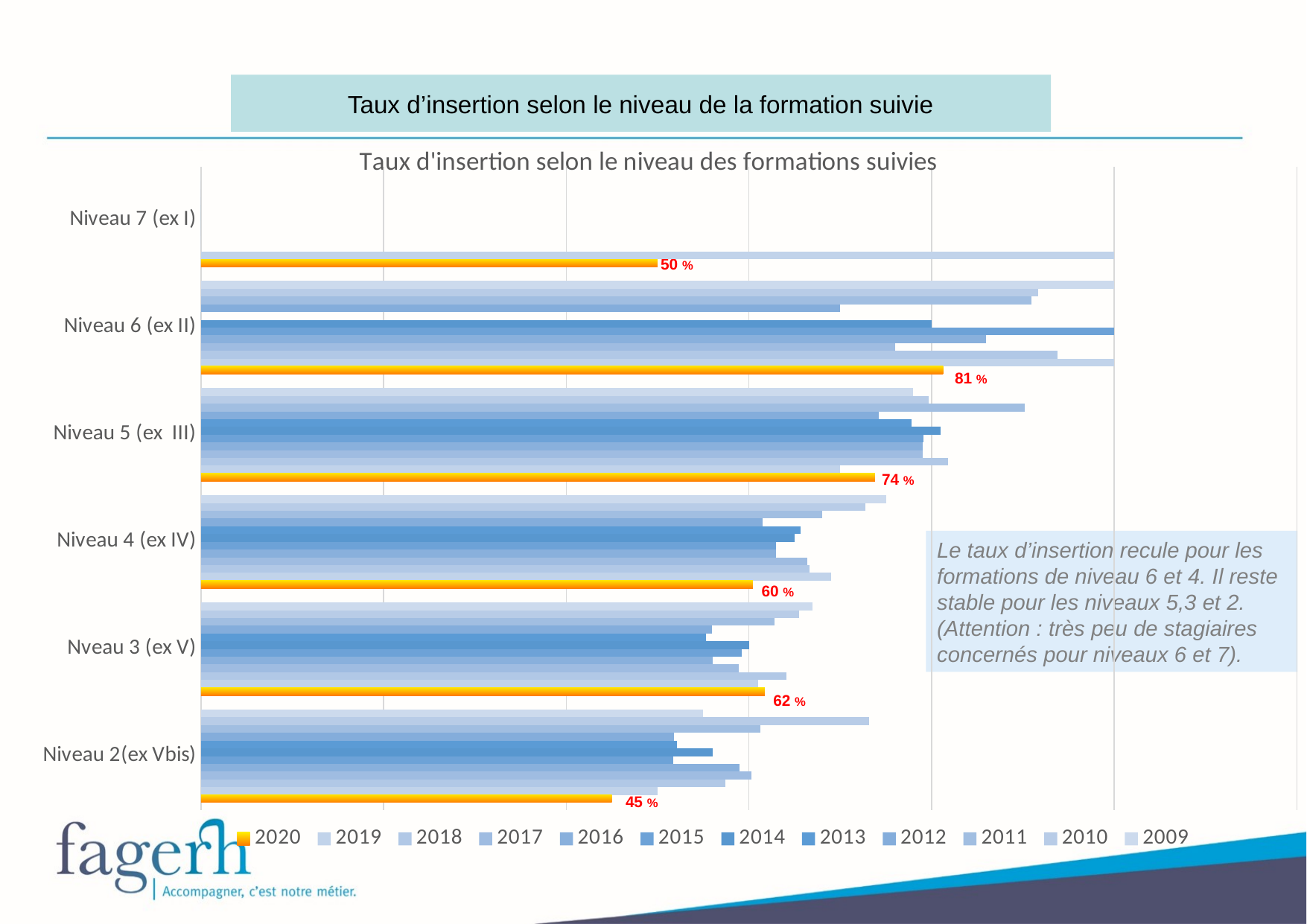
What is the difference between the 2020 insertion rates of Niveau 6 (ex II) and Niveau 2 (ex Vbis)? 36 % What is the 2020 insertion rate for Niveau 4 (ex IV)? 60 % What is the 2020 insertion rate for Niveau 7 (ex I)? 50 % What is the difference between the 2020 insertion rates of Niveau 6 (ex II) and Niveau 5 (ex III)? 7 % What is the 2020 insertion rate for Niveau 2 (ex Vbis)? 45 % Which level has the lowest 2020 insertion rate? Niveau 2 (ex Vbis) Which level has the highest 2020 insertion rate? Niveau 6 (ex II) What is the 2020 insertion rate for Niveau 6 (ex II)? 81 % What type of chart is shown on the slide? Bar chart How many training levels are shown on the chart? 6 In 2020, which has the higher insertion rate: Nveau 3 (ex V) or Niveau 4 (ex IV)? Nveau 3 (ex V) How many series (years) does the legend list? 12